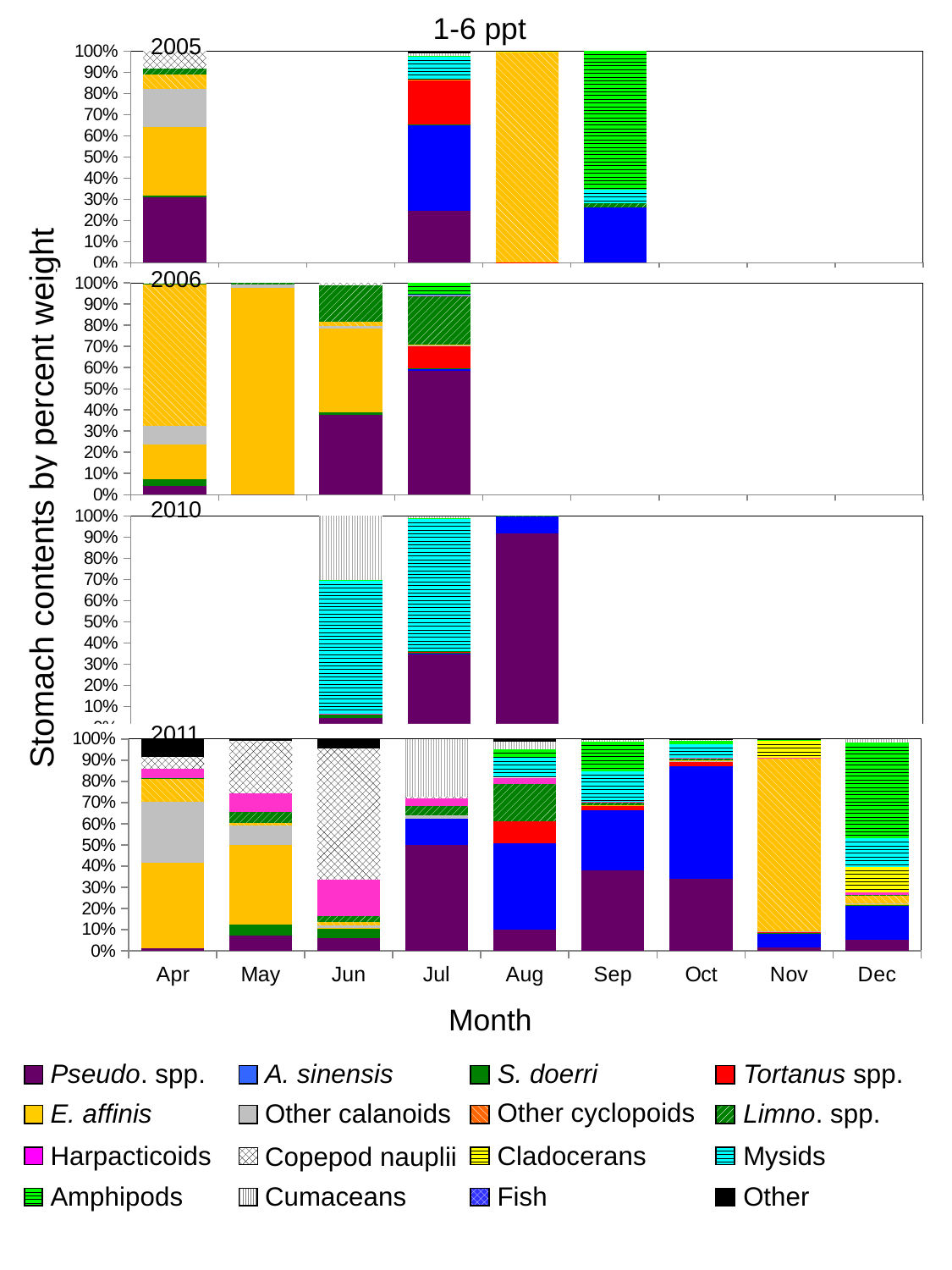
In the 2010 panel, is the Pseudo. spp. share for Aug greater or less than 80%? greater In the 2005 panel, is the E. affinis share for Aug greater or less than 90%? less In the 2005 panel, is the A. sinensis share for Sep greater or less than 50%? less In the 2011 panel, which month has the larger E. affinis share, Apr or Nov? Apr How many series does the legend list? 16 How many months are labelled along the x axis? 9 In the 2010 panel, which month has the larger Pseudo. spp. share, Jul or Aug? Aug In the 2005 panel, how many months have a bar plotted? 4 What is the title shown above the charts? 1-6 ppt In the 2010 panel, how many months have a bar plotted? 3 What kind of chart is shown on the slide? Stacked bar chart